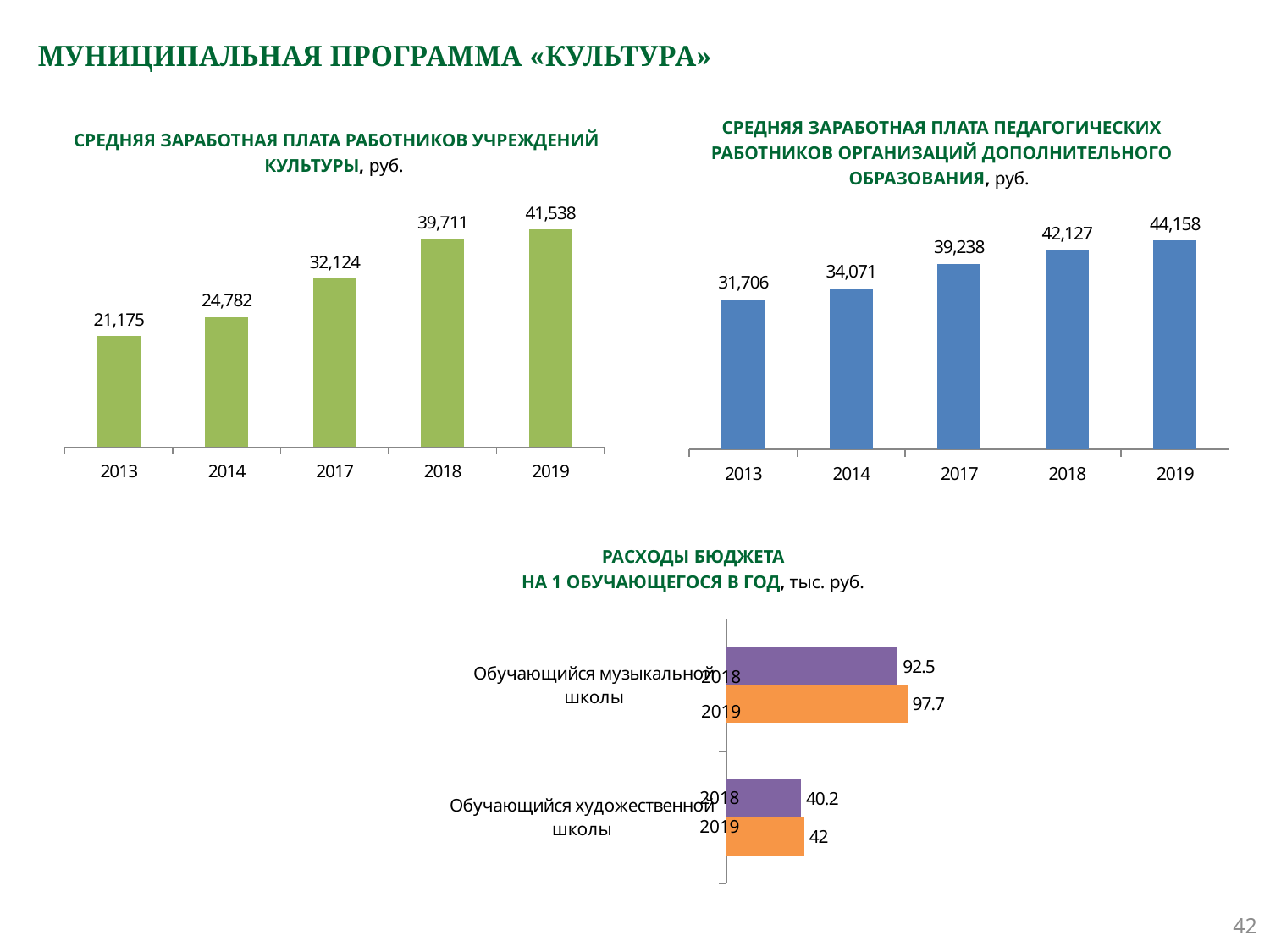
In the bottom chart (budget expenditure per student per year), what is the 2019 value for a music school student? 97.7 In the top-left chart (average salary of cultural institution workers), do the values rise or fall from 2013 to 2019? rise What type of chart is the bottom chart (budget expenditure per student per year)? bar chart In the top-right chart (average salary of teaching staff in supplementary education organisations), what is the difference between the 2017 and 2013 values? 7,532 In the top-left chart (average salary of cultural institution workers), what is the value for 2017? 32,124 In the top-right chart (average salary of teaching staff in supplementary education organisations), how many years are shown on the x axis? 5 In the top-left chart (average salary of cultural institution workers), what is the difference between the 2019 and 2018 values? 1,827 In the bottom chart (budget expenditure per student per year), what is the difference between the 2019 and 2018 values for an art school student? 1.8 Which is larger for 2019: the value in the top-left chart (cultural institution workers) or the value in the top-right chart (teaching staff in supplementary education)? top-right chart (44,158) In the top-right chart (average salary of teaching staff in supplementary education organisations), what is the value for 2014? 34,071 In the top-right chart (average salary of teaching staff in supplementary education organisations), which year has the highest value? 2019 In the top-left chart (average salary of cultural institution workers), which year has the lowest value? 2013